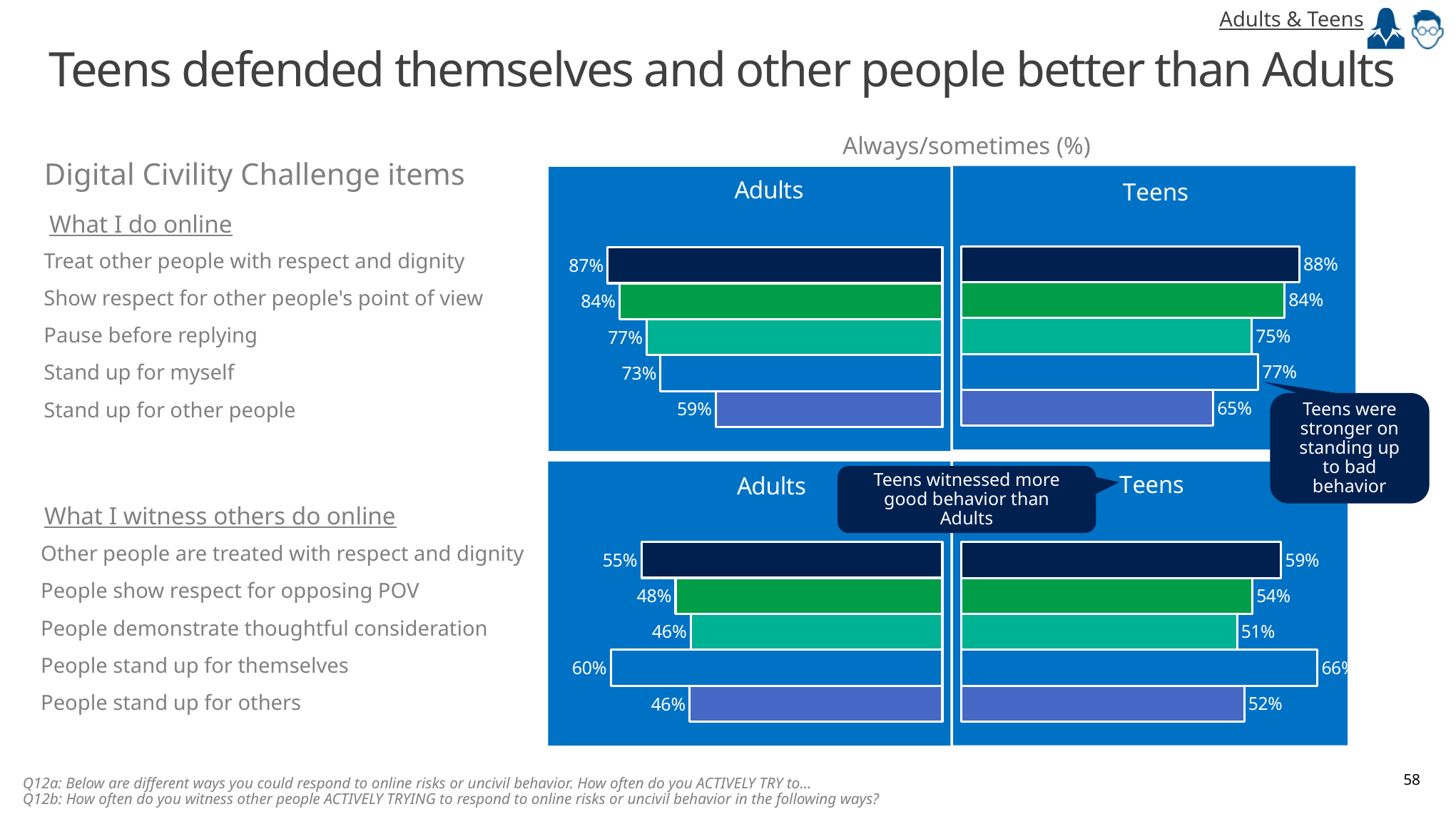
In the "What I do online" chart, what is the difference between Teens and Adults for "Stand up for other people"? 6 percentage points In the "What I witness others do online" chart, what percentage of Adults say people show respect for opposing POV? 48% In the "What I do online" chart, which item has the lowest value for Adults? Stand up for other people In the "What I do online" chart, what percentage of Adults say they treat other people with respect and dignity? 87% How many items are plotted in the "What I do online" chart? 5 In the "What I do online" chart, who has the higher value for "Pause before replying", Adults or Teens? Adults What type of chart is used to show the Adults and Teens values on this slide? Bar chart In the "What I do online" chart, what percentage of Teens say they stand up for other people? 65% In the "What I witness others do online" chart, what percentage of Teens say people stand up for themselves? 66% In the "What I witness others do online" chart, which item has the highest value for Teens? People stand up for themselves In the "What I witness others do online" chart, what is the difference between Teens and Adults for "People stand up for others"? 6 percentage points In the "What I witness others do online" chart, who has the higher value for "People demonstrate thoughtful consideration", Adults or Teens? Teens